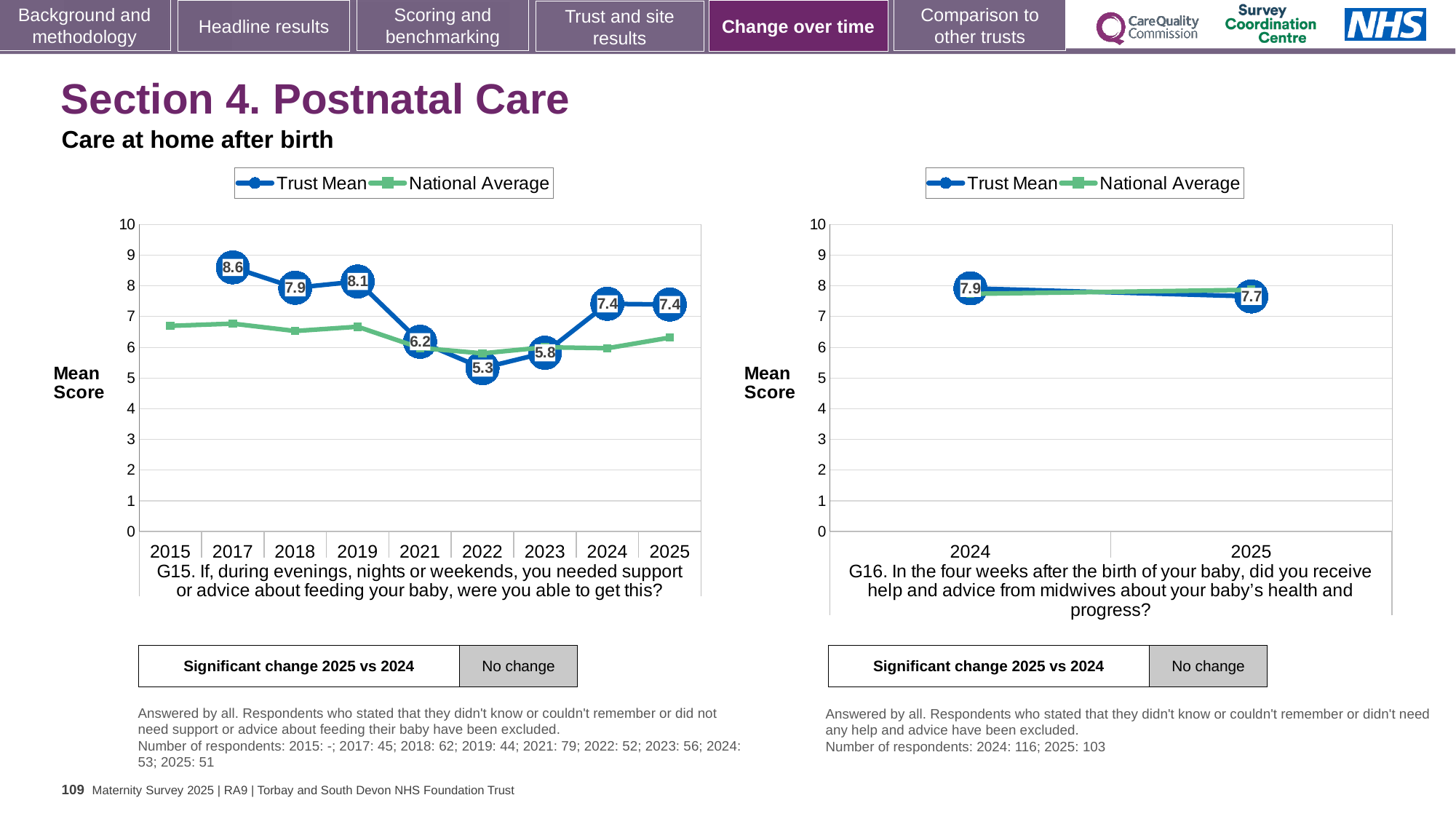
In the G15 chart on the left, what is the Trust Mean score for 2022? 5.3 In the G15 chart on the left, which year has the lowest Trust Mean score? 2022 In the G15 chart on the left, what is the Trust Mean score for 2017? 8.6 In the G16 chart on the right, what is the Trust Mean score for 2025? 7.7 In the G16 chart on the right, what is the difference between the Trust Mean scores for 2024 and 2025? 0.2 How many years are shown on the x axis of the G15 chart on the left? 9 In the G15 chart on the left, which is larger: the Trust Mean score for 2019 or for 2021? 2019 In the G15 chart on the left, is the National Average value for 2015 greater or less than 6? greater In the G15 chart on the left, which year has the highest Trust Mean score? 2017 What kind of chart is the G16 chart on the right? Line chart How many series does the legend of the G16 chart on the right list? 2 In the G15 chart on the left, what is the difference between the Trust Mean scores for 2017 and 2022? 3.3